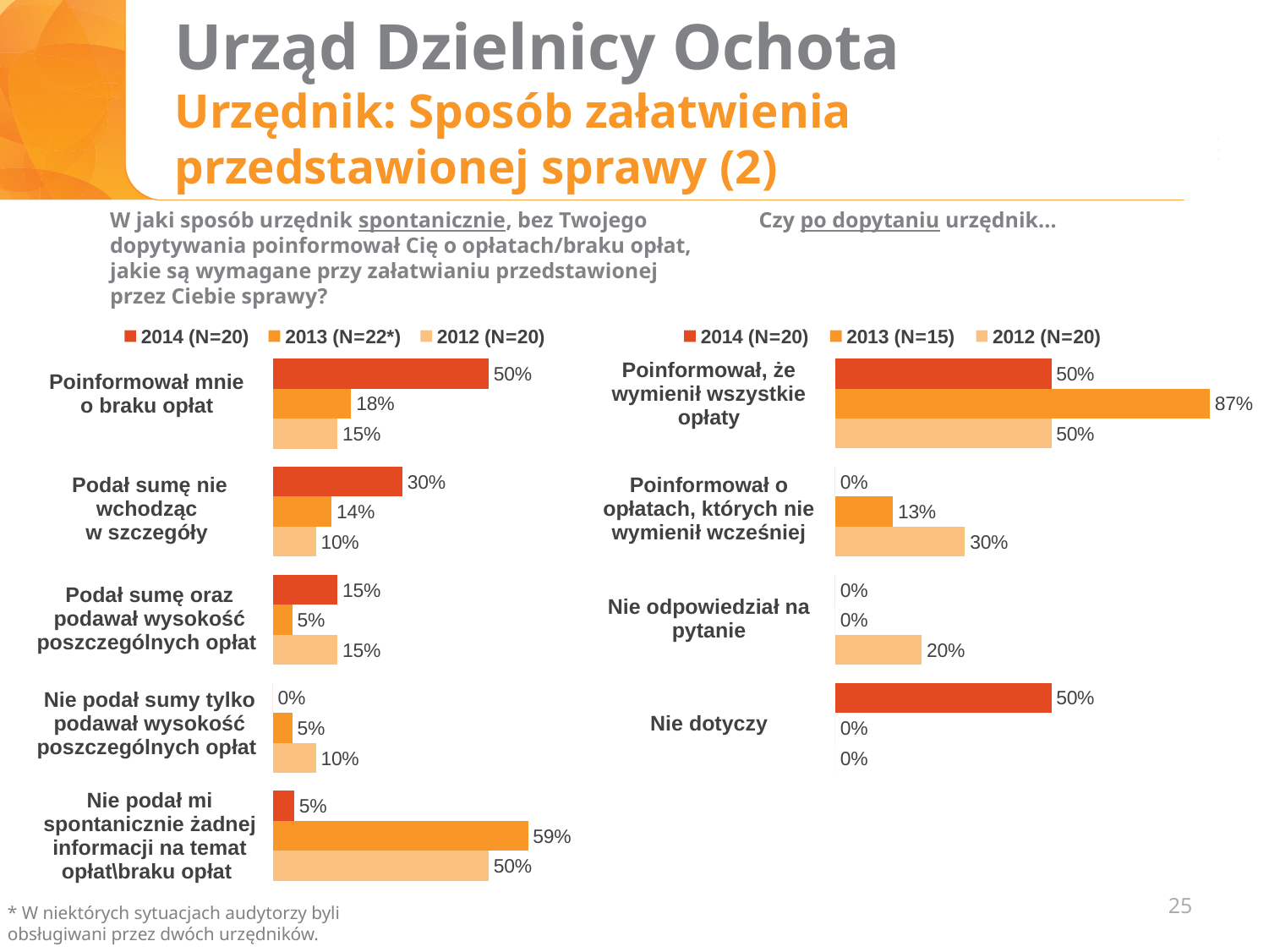
In the left chart (spontaneous information about fees), what is the 2014 (N=20) value for "Poinformował mnie o braku opłat"? 50% In the left chart (spontaneous information about fees), what is the 2013 (N=22*) value for "Nie podał mi spontanicznie żadnej informacji na temat opłat\braku opłat"? 59% In the right chart ("Czy po dopytaniu urzędnik..."), what is the difference between the 2012 and 2013 values for "Poinformował o opłatach, których nie wymienił wcześniej"? 17 percentage points What type of chart is used on the left side of the slide? Bar chart How many series does the legend of the right chart ("Czy po dopytaniu urzędnik...") list? 3 In the left chart (spontaneous information about fees), which category has the highest 2014 (N=20) value? Poinformował mnie o braku opłat In the right chart ("Czy po dopytaniu urzędnik..."), which category has the highest 2012 (N=20) value? Poinformował, że wymienił wszystkie opłaty In the right chart ("Czy po dopytaniu urzędnik..."), what is the 2013 (N=15) value for "Poinformował, że wymienił wszystkie opłaty"? 87% In the left chart (spontaneous information about fees), which is larger for "Podał sumę nie wchodząc w szczegóły": the 2014 value or the 2012 value? 2014 In the right chart ("Czy po dopytaniu urzędnik..."), what is the 2012 (N=20) value for "Nie odpowiedział na pytanie"? 20% How many categories does the left chart (spontaneous information about fees) show? 5 In the left chart (spontaneous information about fees), what is the difference between the 2014 and 2013 values for "Poinformował mnie o braku opłat"? 32 percentage points